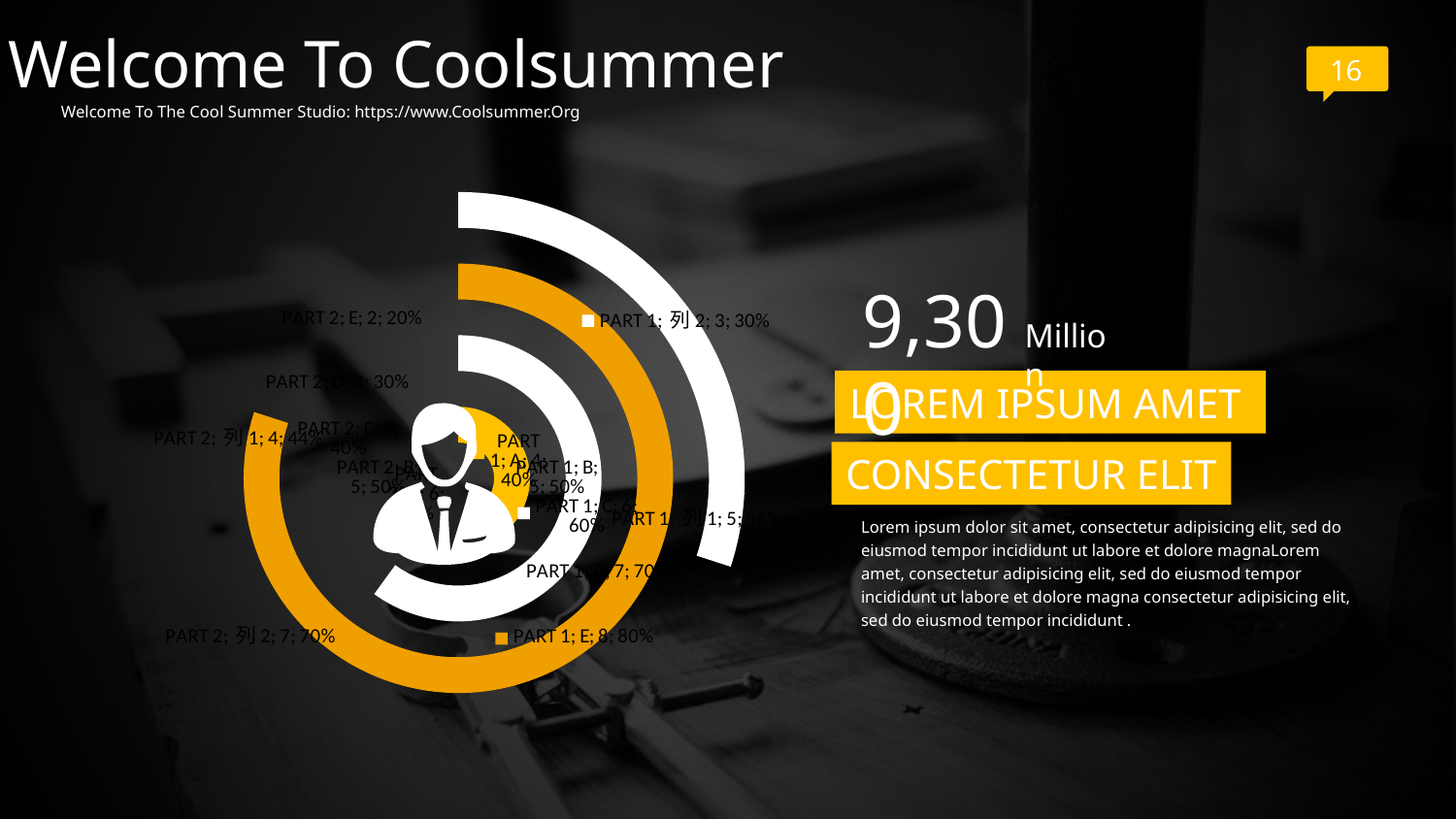
What is the difference between the PART 2 value for 列 2 (70%) and the PART 1 value for 列 2 (30%)? 40% What is the value shown for category E in the PART 2 series? 20% What is the value shown for category E in the PART 1 series? 80% What is the value shown for category 列 1 in the PART 2 series? 44% Which is larger: the PART 1 value for E or the PART 2 value for E? PART 1 value for E How many series are plotted in the chart? 7 What kind of chart is shown on the slide? doughnut chart What is the value shown for category D in the PART 2 series? 30% What is the difference between the PART 1 value for E (80%) and the PART 2 value for E (20%)? 60% What is the value shown for category 列 2 in the PART 1 series? 30% What is the value shown for category 列 2 in the PART 2 series? 70%